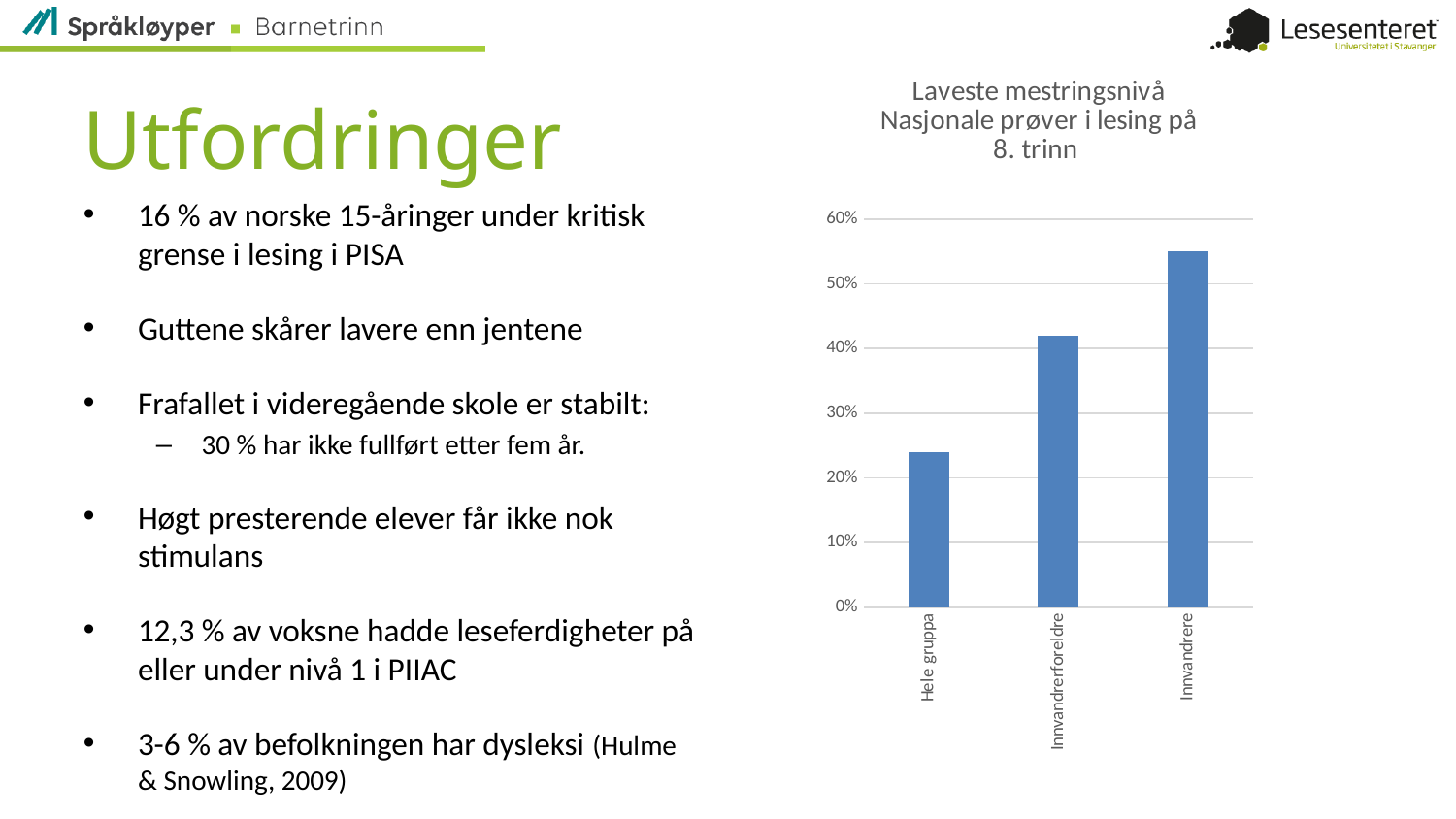
What kind of chart is shown on the slide? bar chart What is the highest value shown on the chart's vertical axis? 60% Do the values rise or fall from left to right across the categories? rise How many categories are shown on the x axis of the chart? 3 Is the value for Innvandrere greater or less than 60%? less Which is larger, the value for Innvandrerforeldre or the value for Hele gruppa? Innvandrerforeldre Is the value for Innvandrere greater or less than 50%? greater Is the value for Innvandrerforeldre greater or less than 40%? greater Which category has the lowest value in the chart? Hele gruppa Which category has the highest value in the chart? Innvandrere What is the title of the chart? Laveste mestringsnivå Nasjonale prøver i lesing på 8. trinn